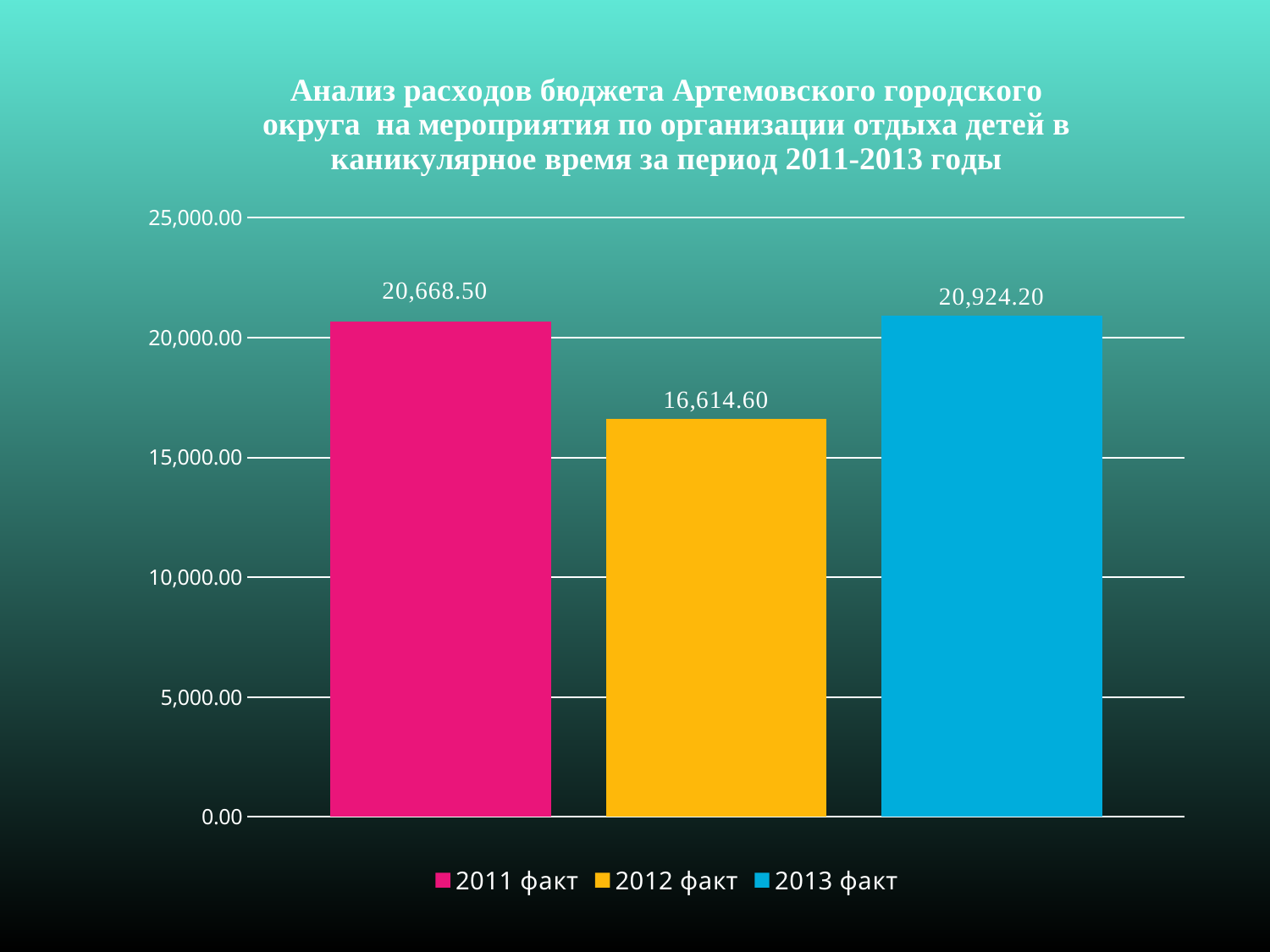
What is the value for 2013 факт? 20,924.20 Which series has the highest value? 2013 факт What is the value for 2011 факт? 20,668.50 Does the value rise or fall from 2012 факт to 2013 факт? rise Is the value for 2012 факт greater or less than 20,000.00? less How many series does the legend list? 3 Which series has the lowest value? 2012 факт What is the difference between the values for 2013 факт and 2011 факт? 255.70 What is the difference between the values for 2011 факт and 2012 факт? 4,053.90 Which is larger, the value for 2011 факт or 2012 факт? 2011 факт What kind of chart is shown on the slide? bar chart What is the value for 2012 факт? 16,614.60